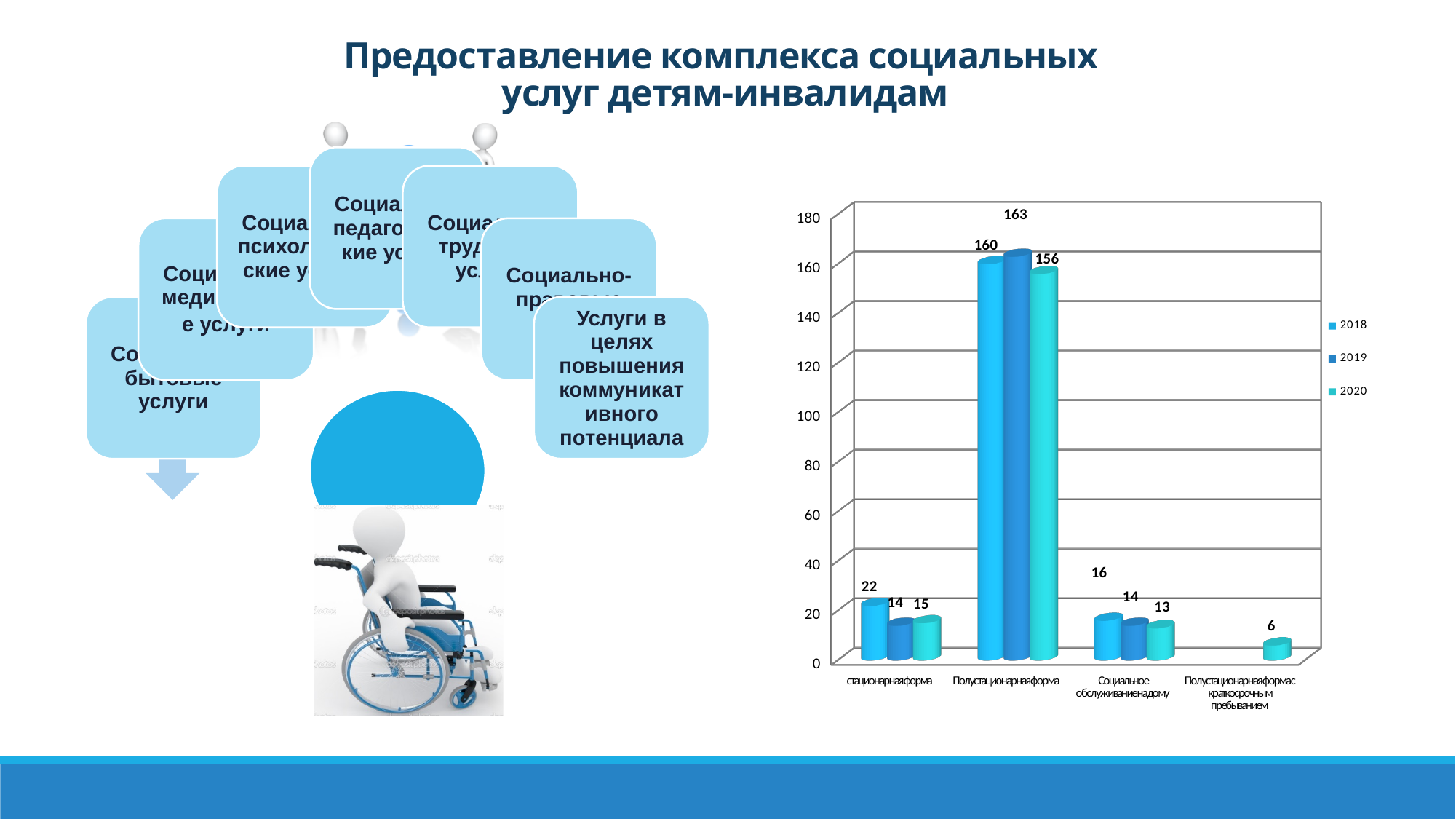
Which category has the highest values across all years? Полустационарная форма Is the 2020 value for "Полустационарная форма" greater or less than 140? greater How many categories are shown on the x axis of the chart? 4 What is the difference between the 2018 and 2019 values in the "стационарная форма" category? 8 How many series does the chart legend list? 3 Which is larger in the "Социальное обслуживание на дому" category: the 2018 value or the 2020 value? 2018 What is the value for 2020 in the "Социальное обслуживание на дому" category? 13 What is the value shown for "Полустационарная форма с краткосрочным пребыванием"? 6 What kind of chart is shown on the slide? Bar chart What is the value for 2018 in the "стационарная форма" category? 22 Which year has the lowest value in the "Полустационарная форма" category? 2020 What is the value for 2019 in the "Полустационарная форма" category? 163